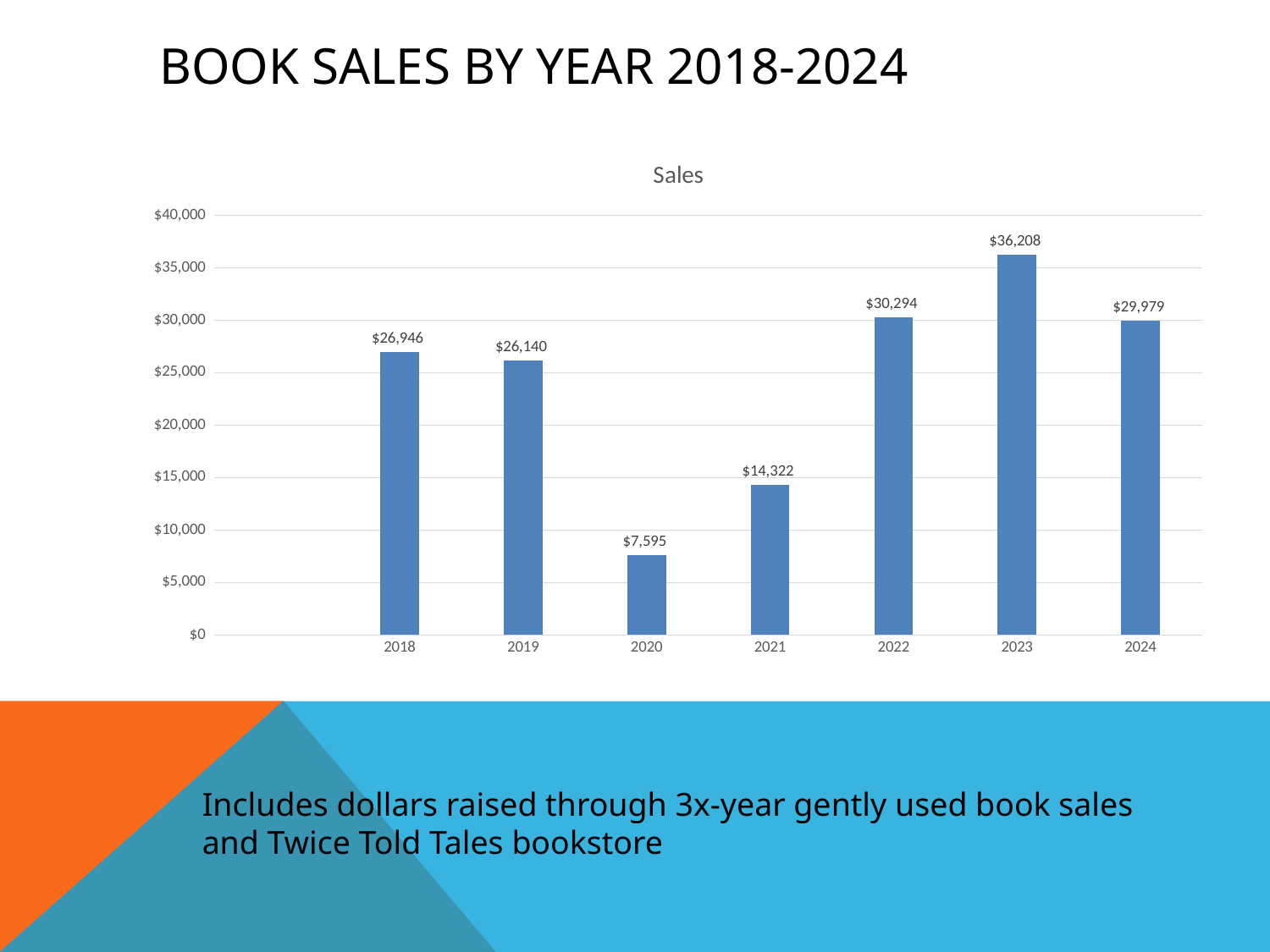
Which year has the lowest sales in the chart? 2020 Which year has higher sales, 2022 or 2024? 2022 What is the difference between the sales for 2023 and 2022? $5,914 What is the value for 2023 in the Sales chart? $36,208 Is the value for 2019 greater or less than $25,000? greater Which year has the highest sales in the chart? 2023 From 2020 to 2023, do the sales values rise or fall? Rise What kind of chart is shown on the slide? Bar chart What is the value for 2021 in the Sales chart? $14,322 What is the difference between the sales for 2021 and 2020? $6,727 How many years are shown in the chart? 7 What is the value for 2020 in the Sales chart? $7,595